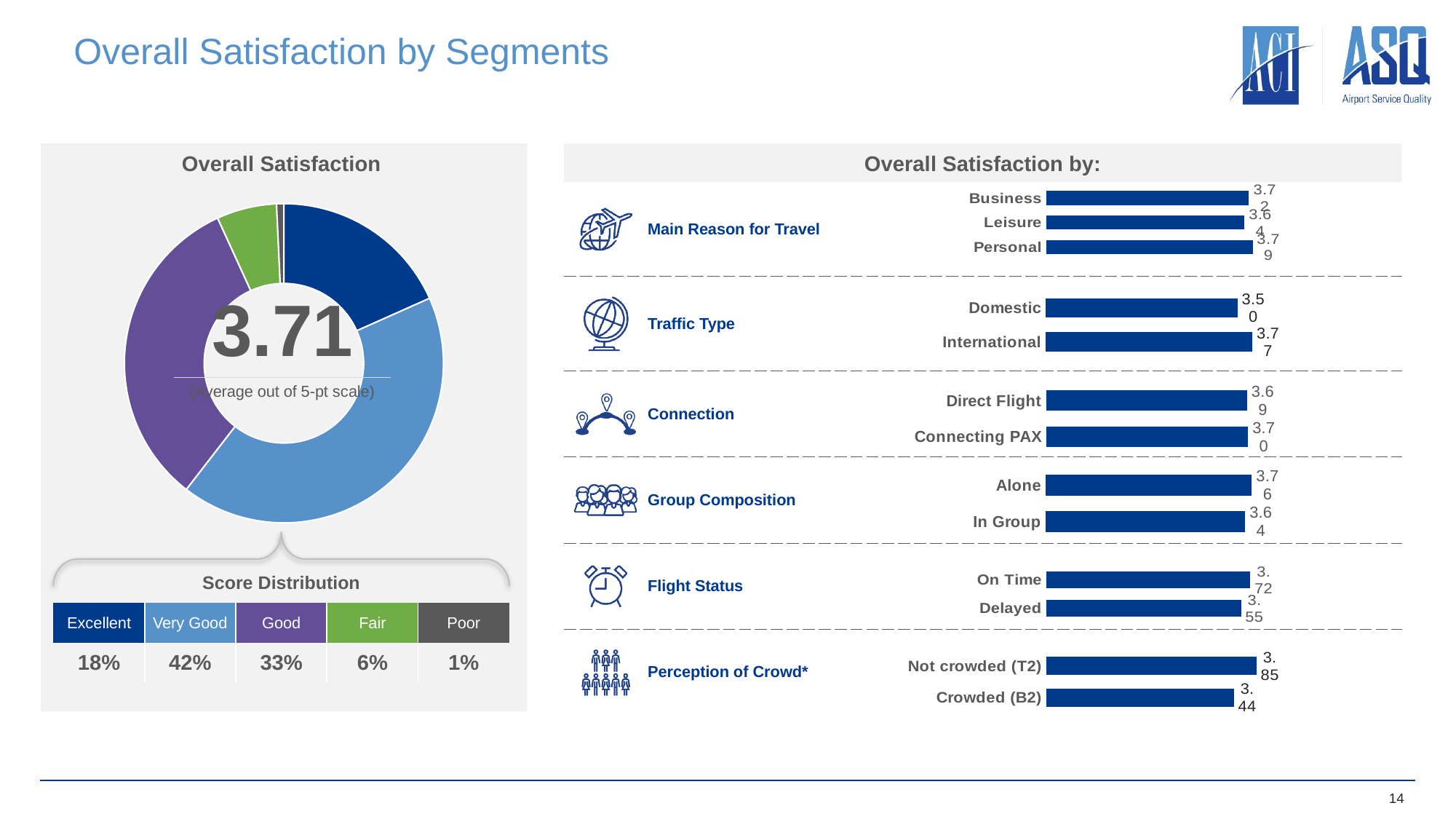
What is the overall satisfaction average shown in the centre of the donut chart? 3.71 What type of chart is used for the Group Composition segment? Bar chart In the Main Reason for Travel bar chart, what is the satisfaction score for Personal? 3.79 In the Flight Status bar chart, which is higher, On Time or Delayed? On Time In the Overall Satisfaction donut chart, which rating category has the smallest share? Poor In the Traffic Type bar chart, what is the difference between International and Domestic? 0.27 In the Overall Satisfaction donut chart, which rating category has the largest share? Very Good In the Perception of Crowd bar chart, what is the score for Crowded (B2)? 3.44 In the Overall Satisfaction donut chart, what is the difference in percentage points between Good and Excellent? 15 How many rating categories are shown in the Score Distribution of the Overall Satisfaction donut chart? 5 In the Main Reason for Travel bar chart, which category has the lowest score? Leisure In the Overall Satisfaction donut chart, what percentage of respondents rated Very Good? 42%